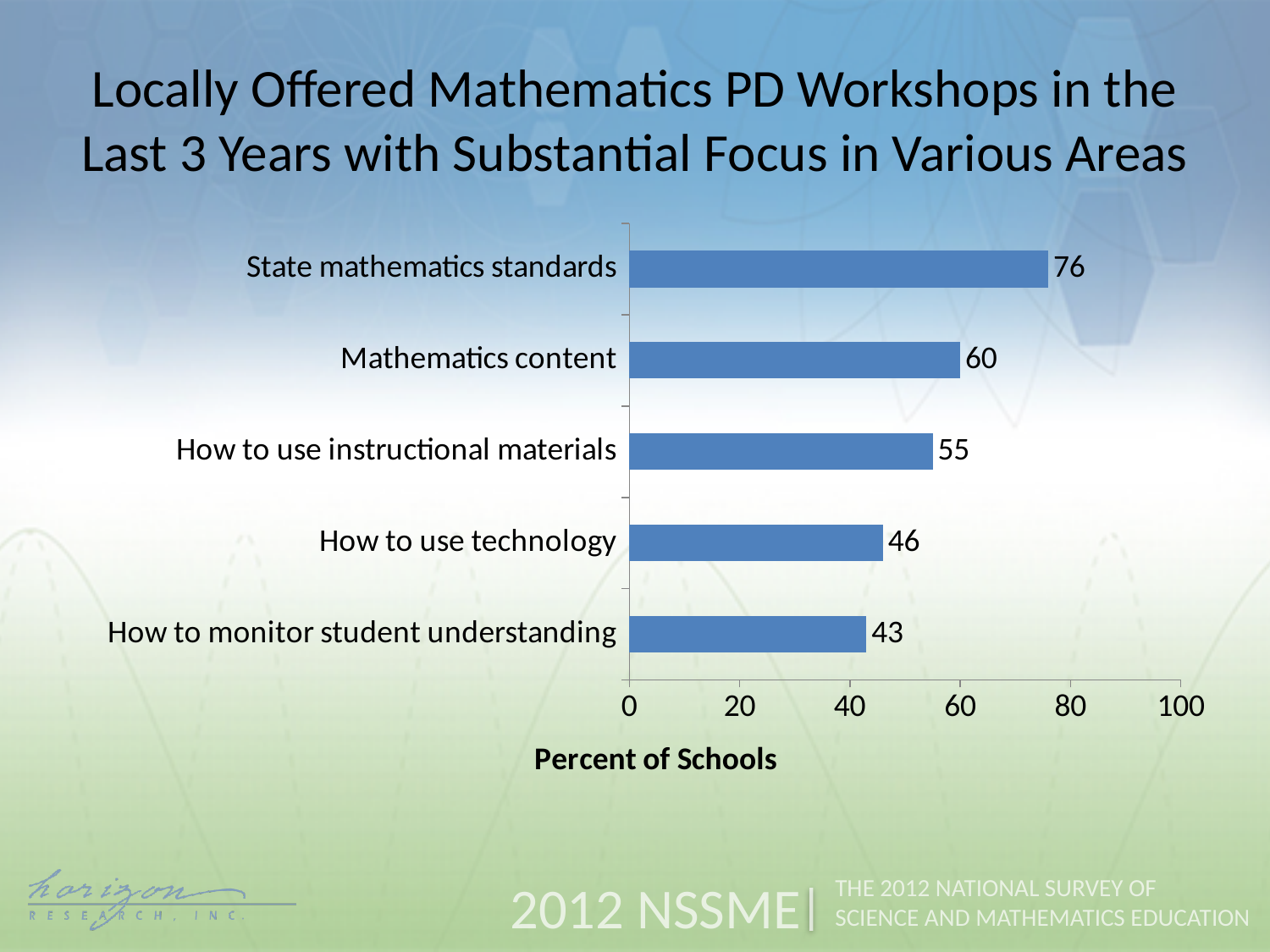
Which area has the highest percent of schools? State mathematics standards What is the value for 'Mathematics content'? 60 Which is larger: the value for 'How to use instructional materials' or 'How to use technology'? How to use instructional materials What is the label of the horizontal axis? Percent of Schools Which area has the lowest percent of schools? How to monitor student understanding What percent of schools had locally offered mathematics PD workshops with substantial focus on state mathematics standards? 76 What is the difference between the values for 'Mathematics content' and 'How to use instructional materials'? 5 What is the difference between the values for 'State mathematics standards' and 'How to monitor student understanding'? 33 How many areas (categories) are shown in the chart? 5 Is the value for 'How to use technology' greater or less than 40? greater What kind of chart is shown on the slide? Bar chart What is the value for 'How to use technology'? 46